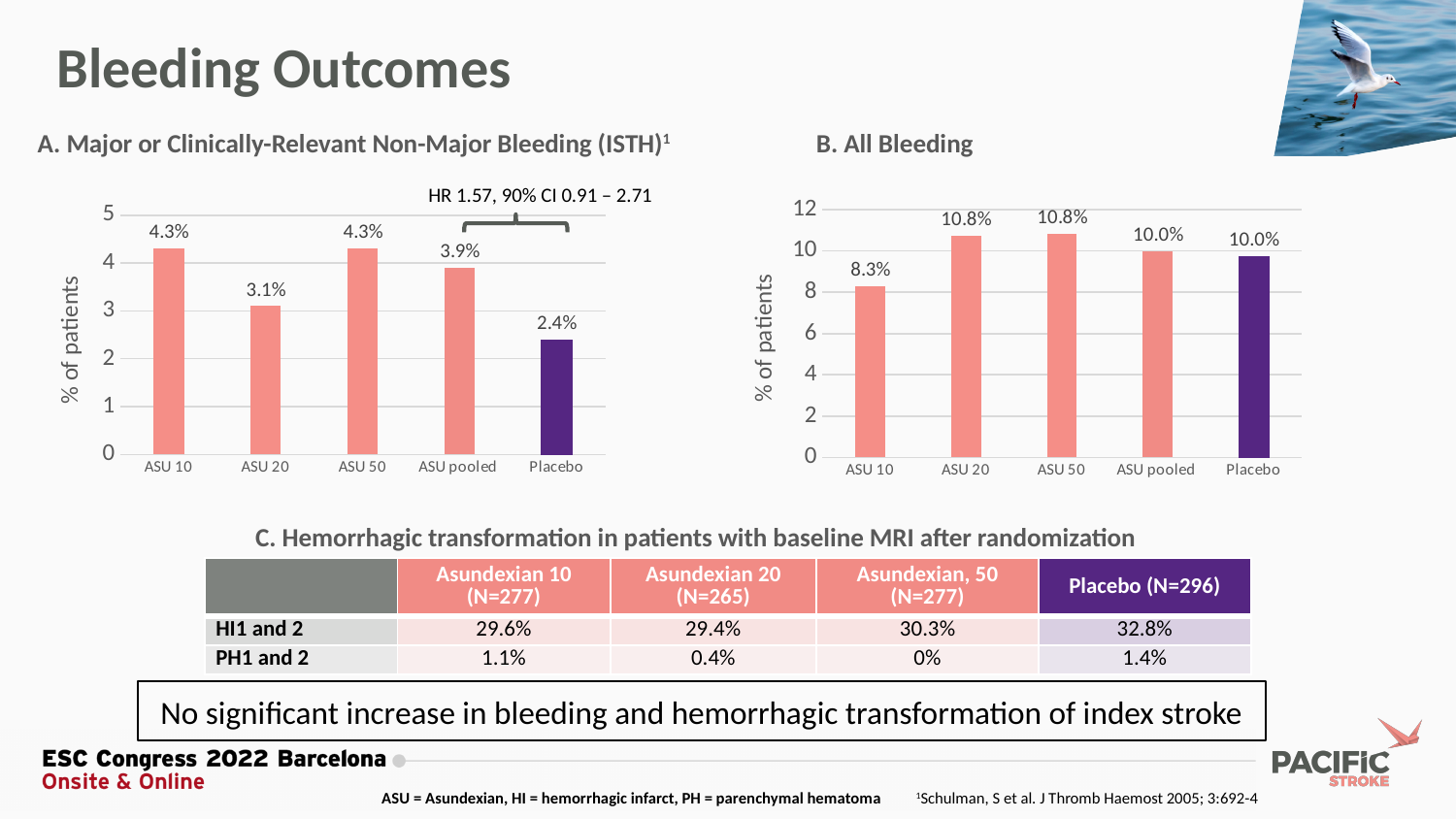
What type of chart is chart A (Major or Clinically-Relevant Non-Major Bleeding)? Bar chart In chart A (Major or Clinically-Relevant Non-Major Bleeding), what is the y-axis label? % of patients In chart A (Major or Clinically-Relevant Non-Major Bleeding), what is the value for ASU 20? 3.1% In chart B (All Bleeding), what is the difference between ASU 20 and ASU 10? 2.5% In chart B (All Bleeding), what is the value for ASU pooled? 10.0% In chart B (All Bleeding), which category has the lowest value? ASU 10 In chart B (All Bleeding), what is the value for ASU 10? 8.3% In chart A (Major or Clinically-Relevant Non-Major Bleeding), which is larger, ASU 10 or ASU 20? ASU 10 In chart A (Major or Clinically-Relevant Non-Major Bleeding), what is the difference between ASU pooled and Placebo? 1.5% In chart B (All Bleeding), how many categories are shown on the x axis? 5 In chart A (Major or Clinically-Relevant Non-Major Bleeding), which category has the lowest value? Placebo In chart A (Major or Clinically-Relevant Non-Major Bleeding), what is the value for Placebo? 2.4%